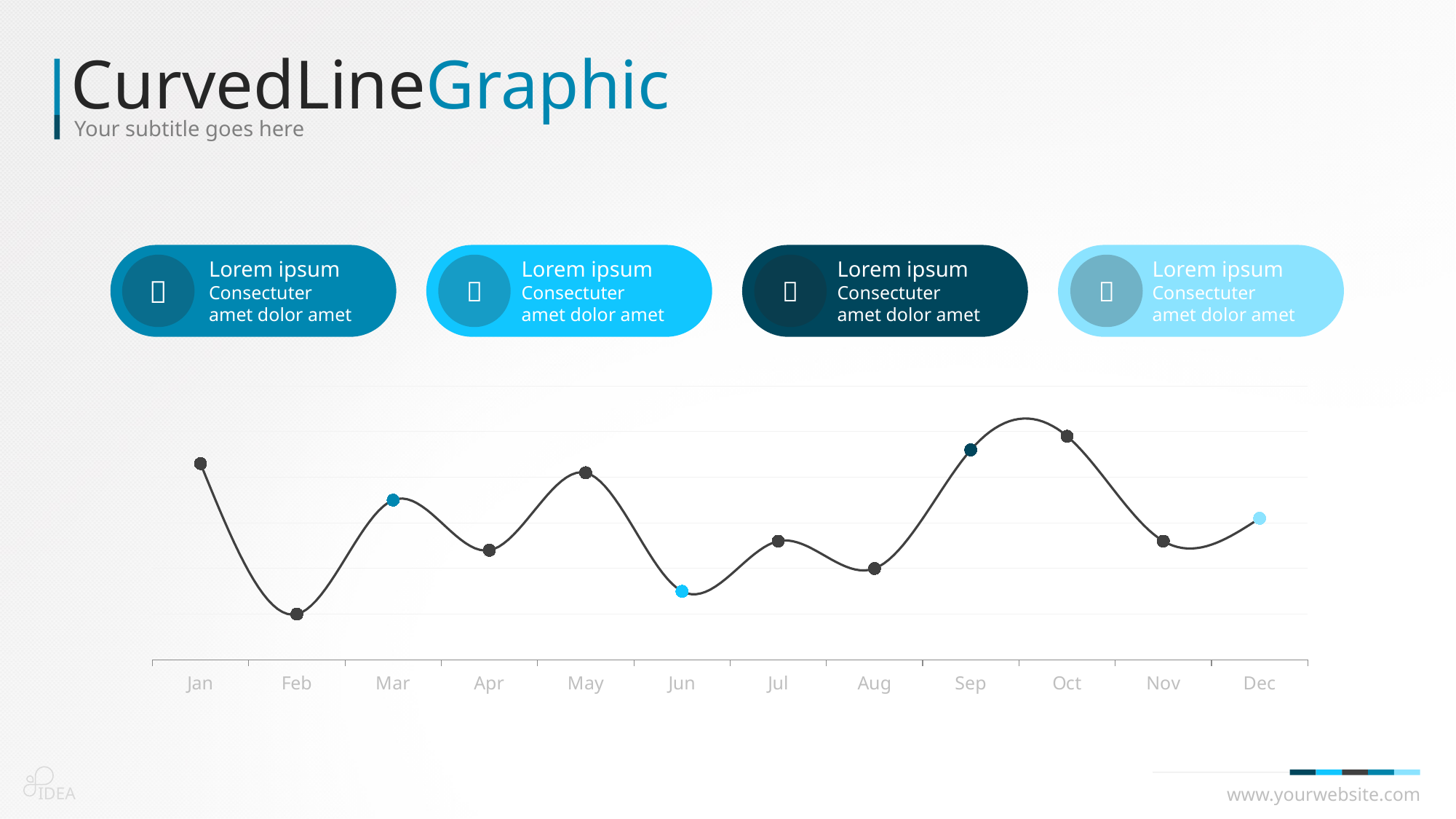
Does the line rise or fall from Jan to Feb? fall Does the line rise or fall from Oct to Nov? fall What do the labels along the x axis of the line chart represent? months (Jan to Dec) Which is higher on the line chart, the value for Jul or the value for Aug? Jul How many data points are plotted on the line chart? 12 Which is higher on the line chart, the value for Nov or the value for Dec? Dec Which month has the lowest point on the line chart? Feb Which is higher on the line chart, the value for Apr or the value for May? May What is the title of the slide containing the line chart? Curved Line Graphic What kind of chart is shown on the slide? line chart